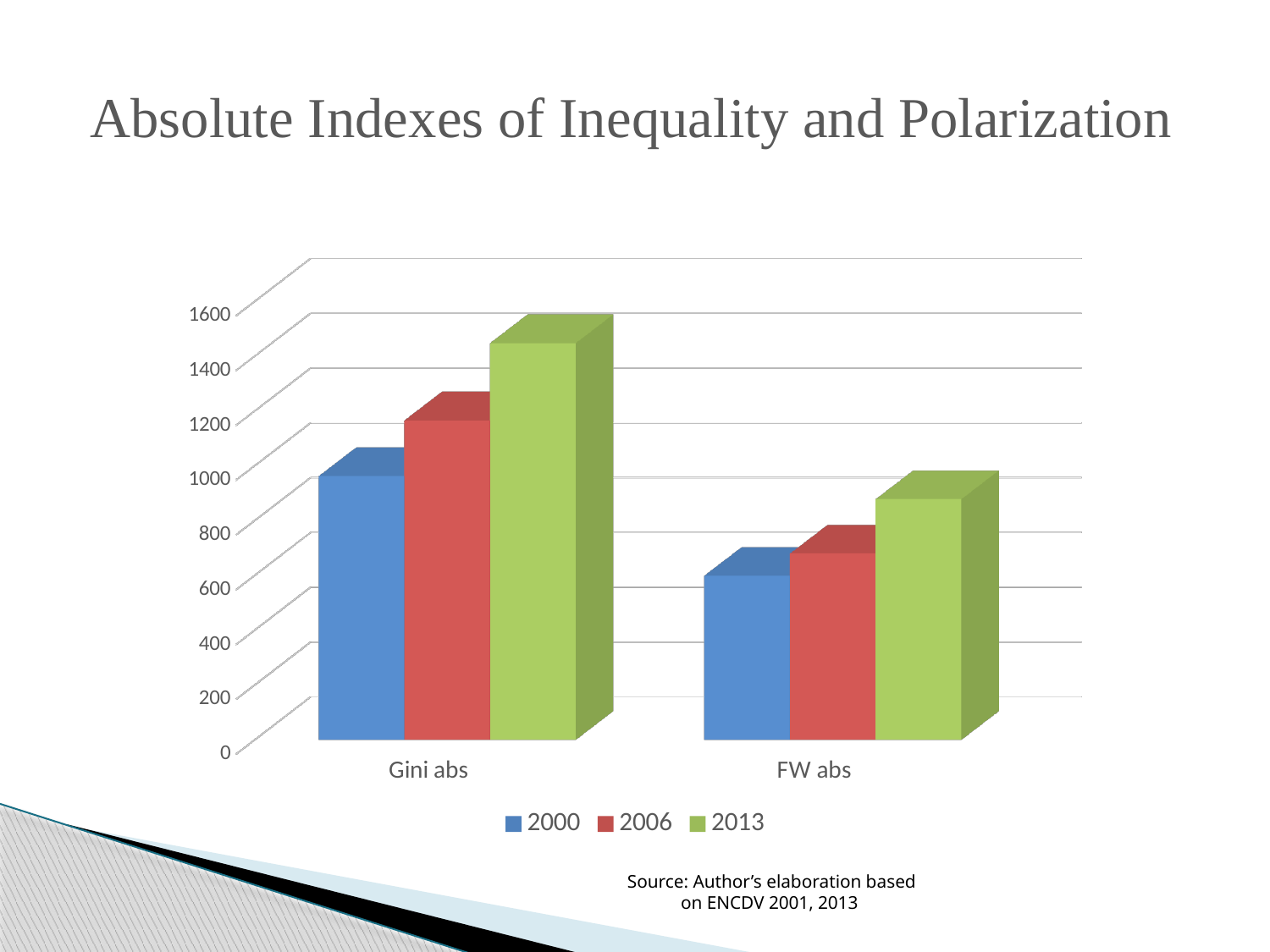
How many categories are shown on the x axis? 2 Is the value for Gini abs in 2013 greater or less than 1400? greater Do the values for FW abs rise or fall from 2000 to 2013? rise Which series has the lowest value for FW abs? 2000 Is the value for FW abs in 2000 greater or less than 800? less What is the title of the slide containing the chart? Absolute Indexes of Inequality and Polarization Which series has the highest value for Gini abs? 2013 Which is larger, the 2013 value for Gini abs or the 2013 value for FW abs? Gini abs What kind of chart is shown on the slide? bar chart Is the value for FW abs in 2013 greater or less than 1000? less How many series does the legend list? 3